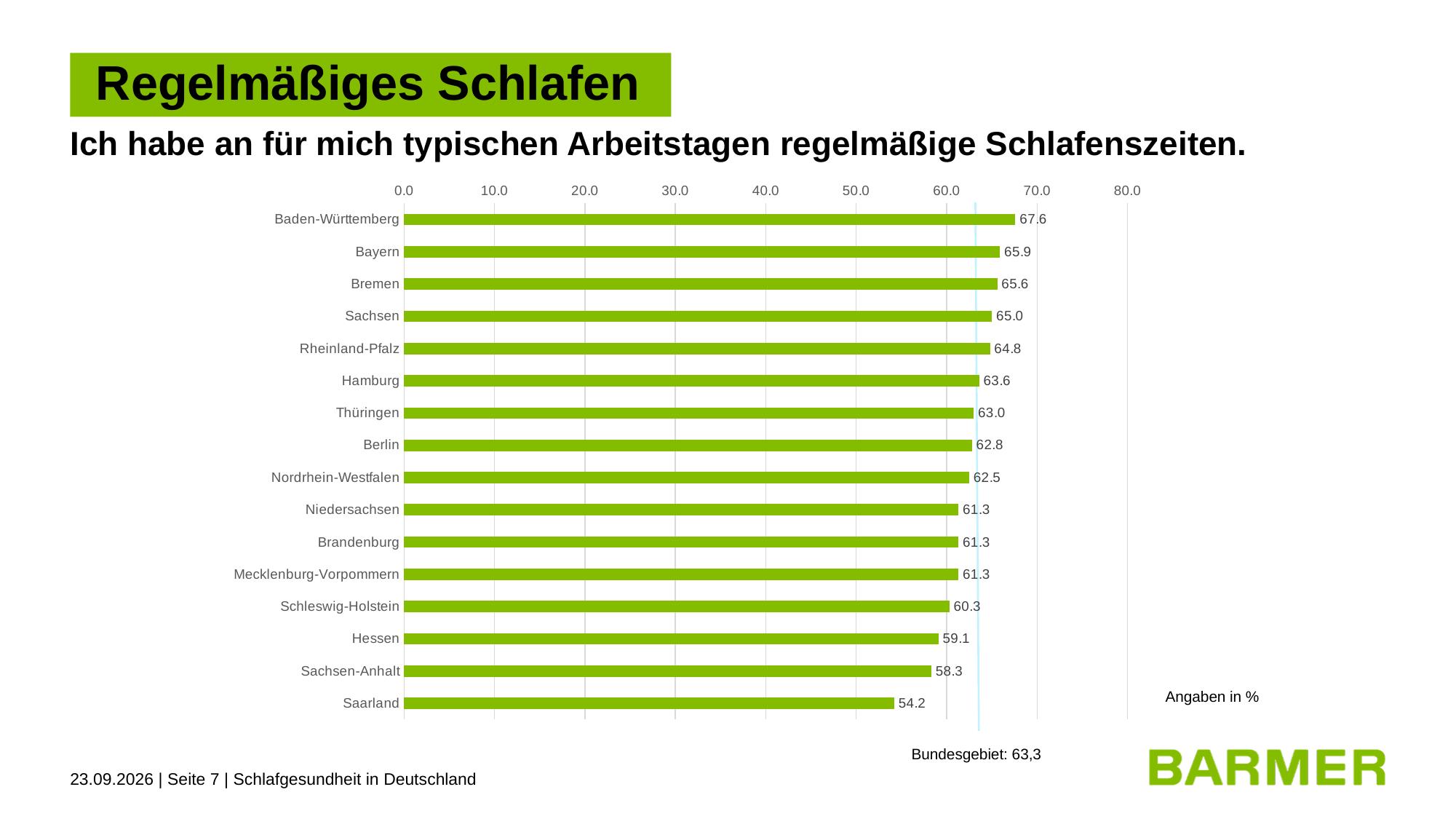
Which federal state has the highest value? Baden-Württemberg What is the value for Hamburg? 63.6 Is the value for Schleswig-Holstein greater or less than 70.0? less How many federal states are shown in the chart? 16 What value is given for Bundesgebiet below the chart? 63,3 What is the difference between the values for Bayern and Hessen? 6.8 What is the value for Saarland? 54.2 Which has a larger value, Sachsen or Sachsen-Anhalt? Sachsen What is the value for Baden-Württemberg? 67.6 Which federal state has the lowest value? Saarland What kind of chart is shown on the slide? bar chart What is the difference between the values for Baden-Württemberg and Saarland? 13.4